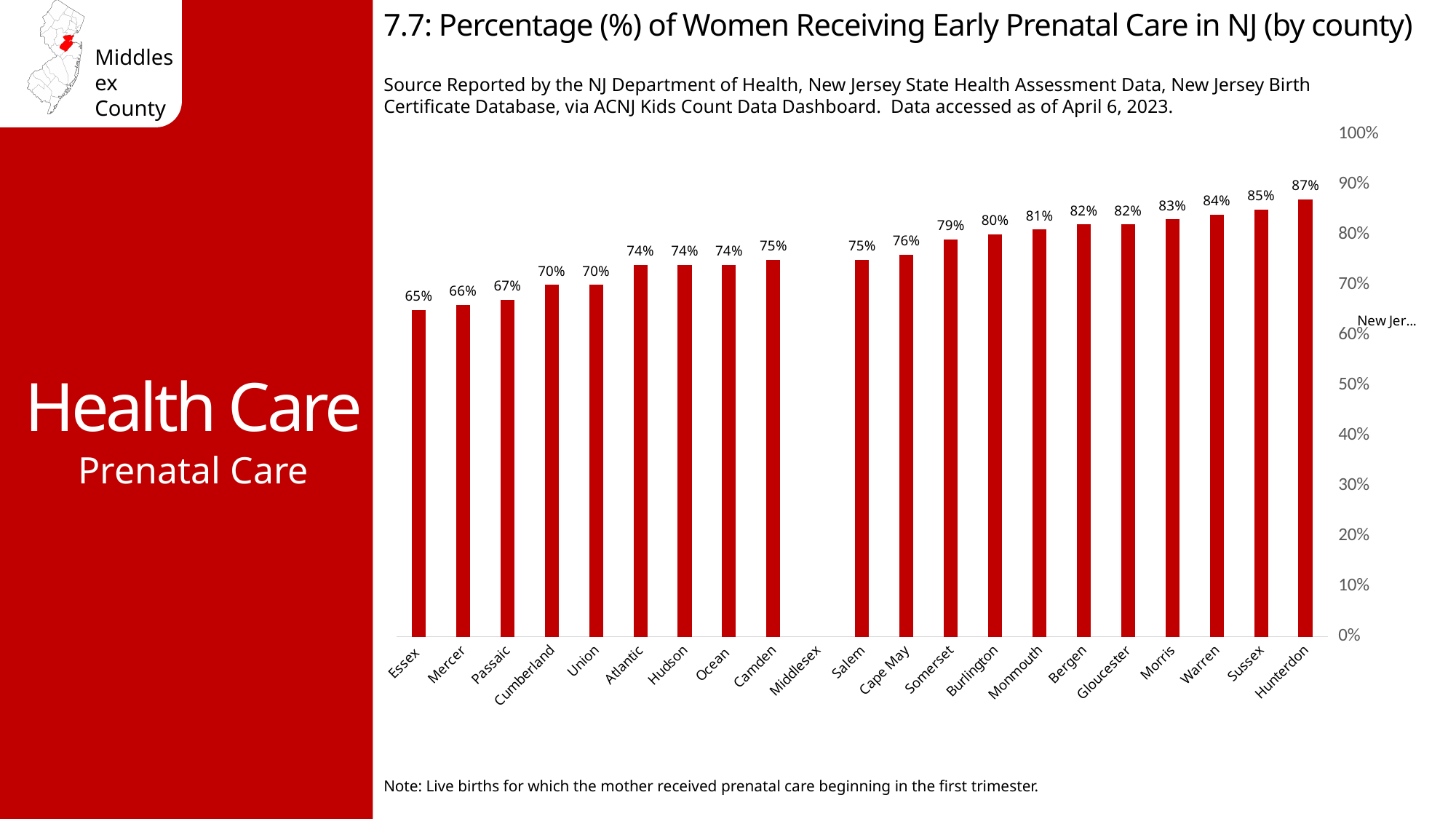
Do the values generally rise or fall moving from left to right along the x axis? Rise What is the percentage of women receiving early prenatal care in Hunterdon? 87% What is the value shown for Somerset? 79% What is the value shown for Essex? 65% What is the difference between the values for Morris and Passaic? 16% What is the difference between the values for Hunterdon and Essex? 22% Which has a higher value, Bergen or Camden? Bergen Which county has the lowest percentage shown on the chart? Essex What is the value shown for Cape May? 76% Is the value for Burlington greater or less than 70%? greater Which county has the highest percentage of women receiving early prenatal care? Hunterdon What kind of chart is shown on the slide? Bar chart